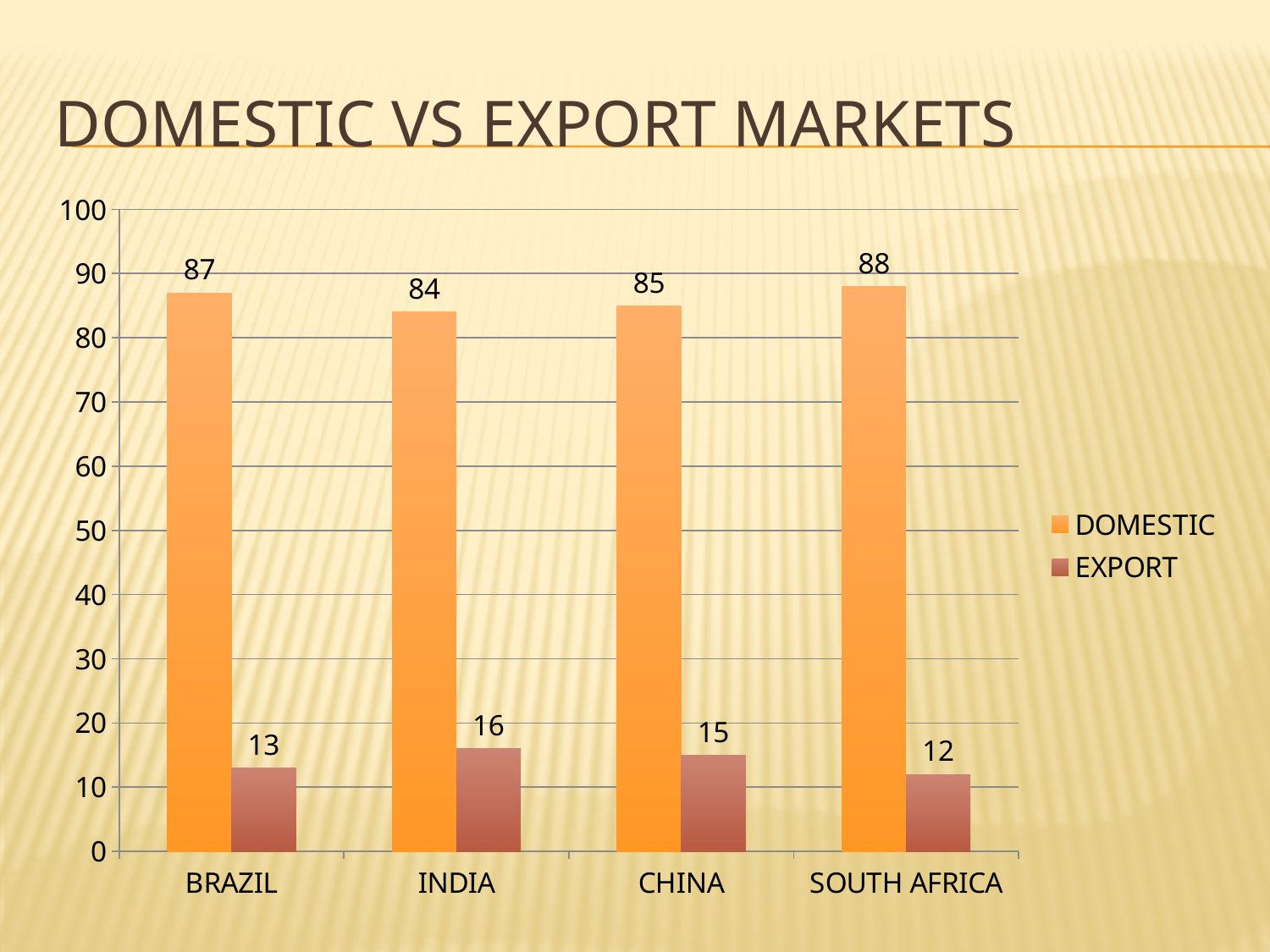
Is the DOMESTIC value for INDIA greater or less than 80? greater Which country has the highest DOMESTIC value? SOUTH AFRICA What is the difference between the DOMESTIC and EXPORT values for CHINA? 70 What is the title of the slide? DOMESTIC VS EXPORT MARKETS How many countries are shown on the x axis? 4 What is the DOMESTIC value for BRAZIL? 87 What kind of chart is shown on the slide? bar chart Which is larger, the EXPORT value for BRAZIL or the EXPORT value for CHINA? CHINA How many series does the legend list? 2 What is the DOMESTIC value for SOUTH AFRICA? 88 Which country has the lowest EXPORT value? SOUTH AFRICA What is the EXPORT value for INDIA? 16